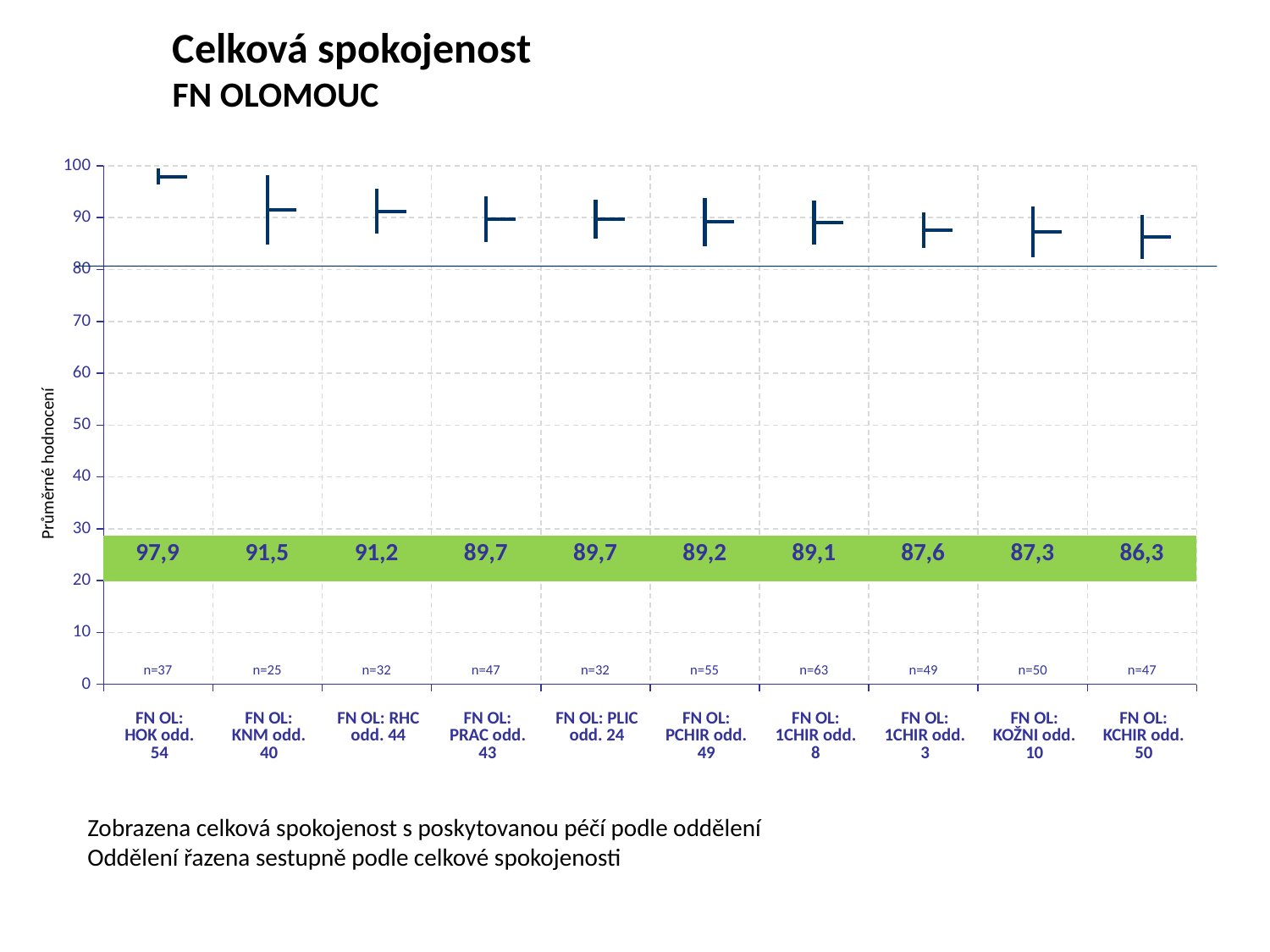
What is the title of the chart? Celková spokojenost FN OLOMOUC What is the average rating (průměrné hodnocení) for FN OL: HOK odd. 54? 97,9 Which department has the highest average rating? FN OL: HOK odd. 54 What is the difference between the average ratings of FN OL: KNM odd. 40 and FN OL: RHC odd. 44? 0,3 What is the sample size (n) shown for FN OL: 1CHIR odd. 8? n=63 Which has a higher average rating: FN OL: PCHIR odd. 49 or FN OL: 1CHIR odd. 3? FN OL: PCHIR odd. 49 Do the average ratings rise or fall from left to right along the x axis? fall What is the average rating shown for FN OL: KOŽNI odd. 10? 87,3 How many departments are shown on the x axis of the chart? 10 Which department has the lowest average rating? FN OL: KCHIR odd. 50 Is the average rating for FN OL: KCHIR odd. 50 greater or less than 80? greater What is the difference between the average ratings of FN OL: HOK odd. 54 and FN OL: KCHIR odd. 50? 11,6